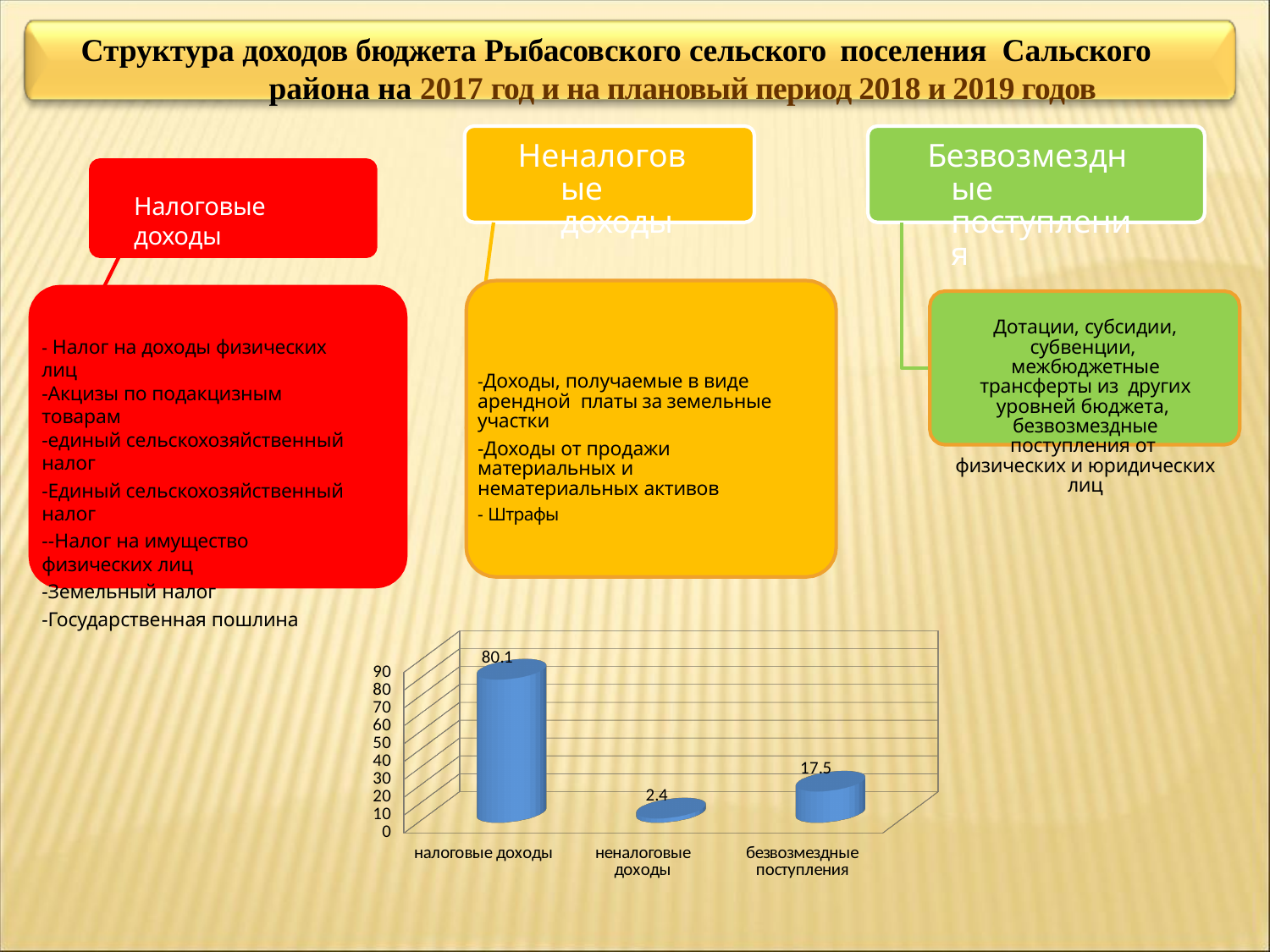
What is the difference between the values for налоговые доходы and безвозмездные поступления? 62.6 Which is larger, the value for безвозмездные поступления or the value for неналоговые доходы? безвозмездные поступления Is the value for налоговые доходы greater or less than 70? greater What kind of chart is shown on the slide? bar chart How many categories are shown in the chart? 3 What is the value for налоговые доходы in the chart? 80.1 What is the value for безвозмездные поступления in the chart? 17.5 Which category has the highest value in the chart? налоговые доходы What is the difference between the values for безвозмездные поступления and неналоговые доходы? 15.1 Is the value for безвозмездные поступления greater or less than 20? less Which category has the lowest value in the chart? неналоговые доходы What is the value for неналоговые доходы in the chart? 2.4